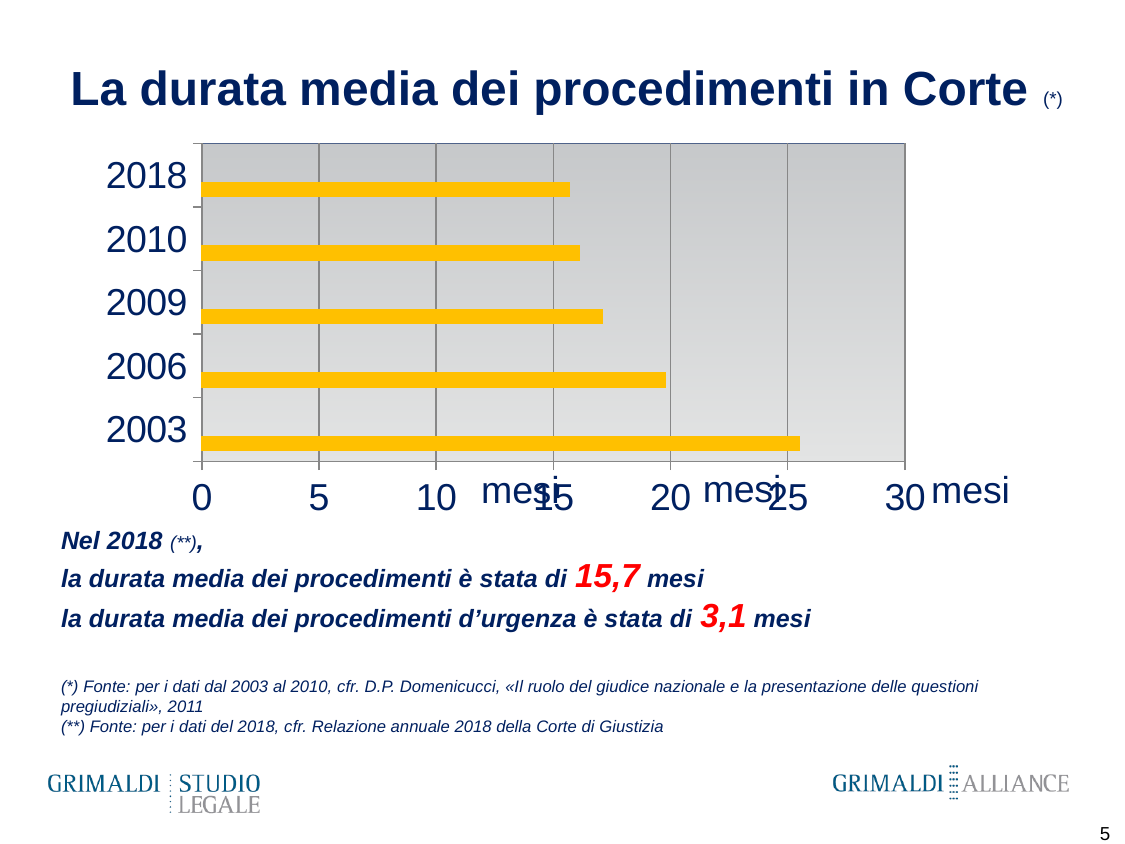
Which is larger, the value for 2009 or the value for 2003? 2003 How many years (categories) are plotted in the chart? 5 Does the average duration of proceedings rise or fall from 2003 to 2018? fall Is the value for 2009 greater or less than 15? greater According to the slide, what was the average duration of proceedings in 2018? 15,7 mesi Which is larger, the value for 2003 or the value for 2006? 2003 Which year has the longest average duration of proceedings in the chart? 2003 What unit is shown on the horizontal axis of the chart? mesi What type of chart is shown on the slide? bar chart According to the slide, what was the average duration of urgent proceedings (procedimenti d'urgenza) in 2018? 3,1 mesi Is the value for 2003 greater or less than 25? greater